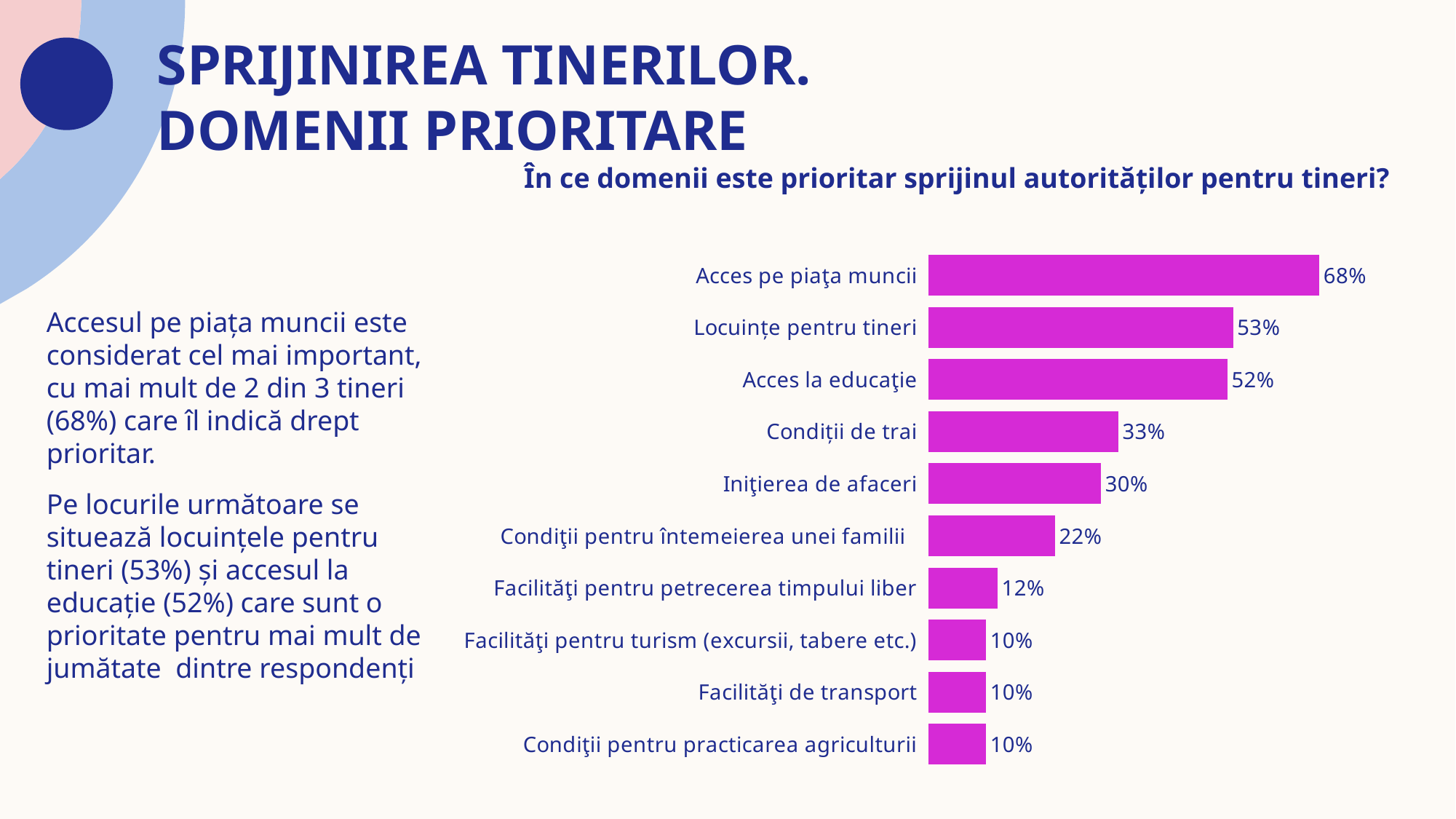
What is the value for "Condiţii pentru întemeierea unei familii"? 22% What is the difference between the values for "Acces pe piaţa muncii" and "Locuințe pentru tineri"? 15% What is the value for "Acces pe piaţa muncii"? 68% How many categories have a value of 10%? 3 What is the title of the chart? În ce domenii este prioritar sprijinul autorităților pentru tineri? Which category has the highest value? Acces pe piaţa muncii What is the value for "Condiții de trai"? 33% What kind of chart is shown on the slide? Bar chart How many categories are shown in the chart? 10 Which is larger, the value for "Iniţierea de afaceri" or the value for "Condiţii pentru întemeierea unei familii"? Iniţierea de afaceri What is the value for "Facilităţi pentru petrecerea timpului liber"? 12% What is the difference between the values for "Condiții de trai" and "Iniţierea de afaceri"? 3%